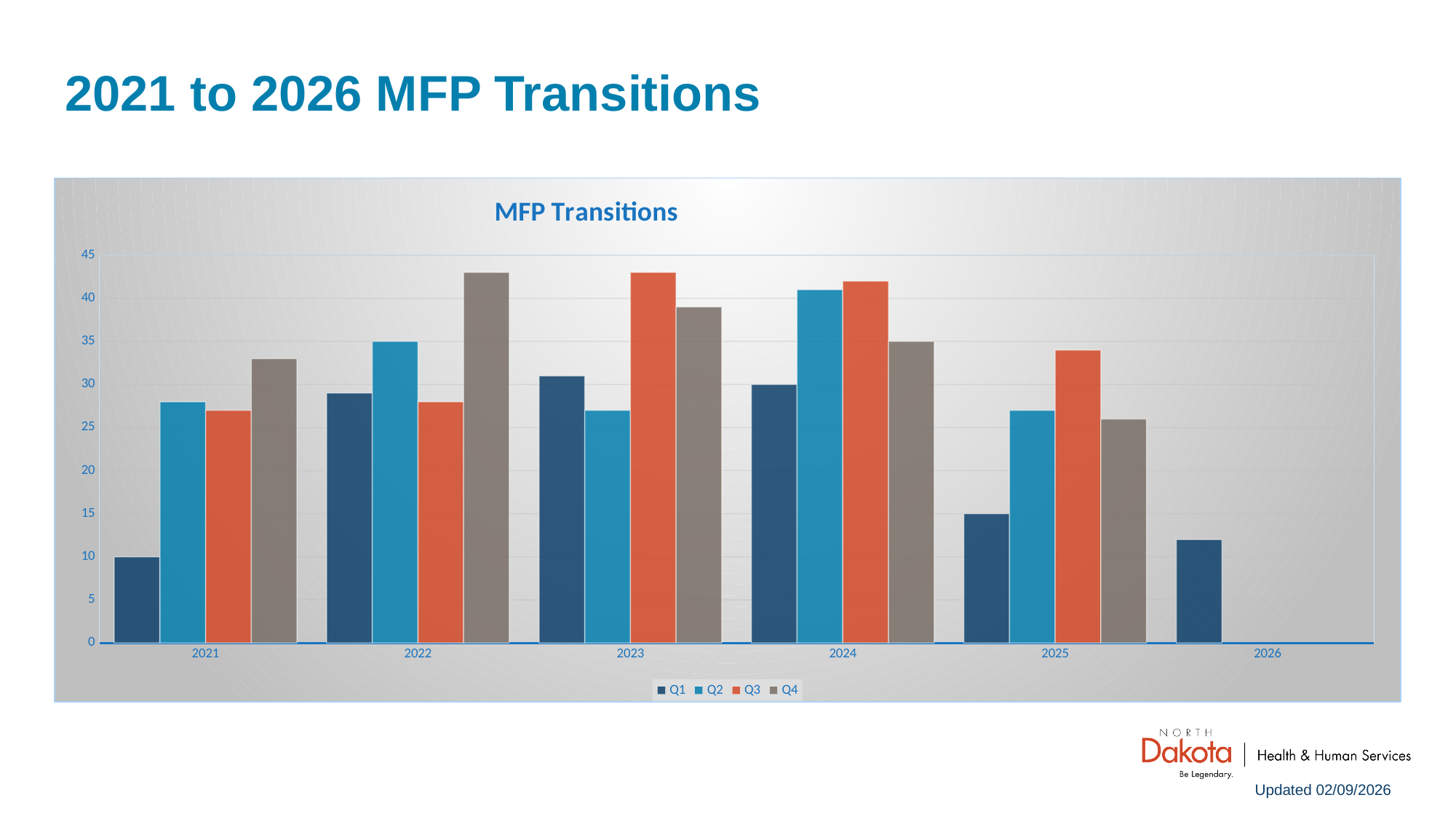
Do the Q1 values rise or fall from 2024 to 2026? fall Is the Q1 value for 2026 greater or less than 15? less Which year has the highest Q4 value? 2022 In 2023, which is larger, the Q2 value or the Q3 value? Q3 What are the legend entries of the chart? Q1, Q2, Q3, Q4 What kind of chart is shown on the slide? bar chart Is the Q4 value for 2022 greater or less than 40? greater How many series does the legend list? 4 Which is larger, the Q2 value for 2024 or the Q2 value for 2025? 2024 How many years are shown along the x axis? 6 What is the title of the chart? MFP Transitions Is the Q2 value for 2021 greater or less than 25? greater